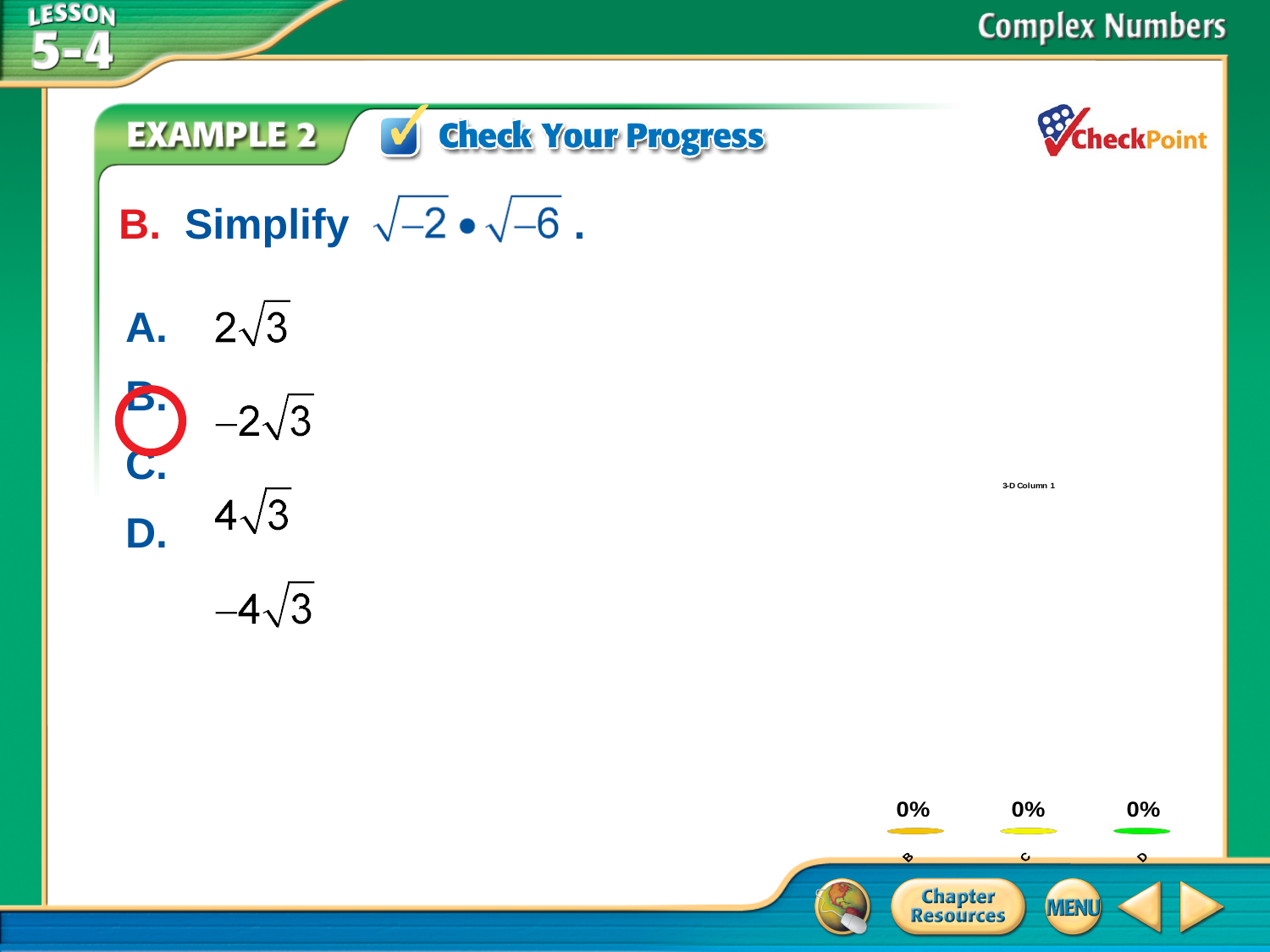
What is the difference between the values for B and D in the chart? 0% How many categories are labeled on the chart's x axis? 3 What value is shown for category C in the chart? 0% What value is shown for category B in the chart? 0% Do the values rise, fall, or stay the same from B to D in the chart? stay the same Which category labels appear on the chart's x axis? B, C, D What value is shown for category D in the chart? 0% What kind of chart is shown on the slide? bar chart